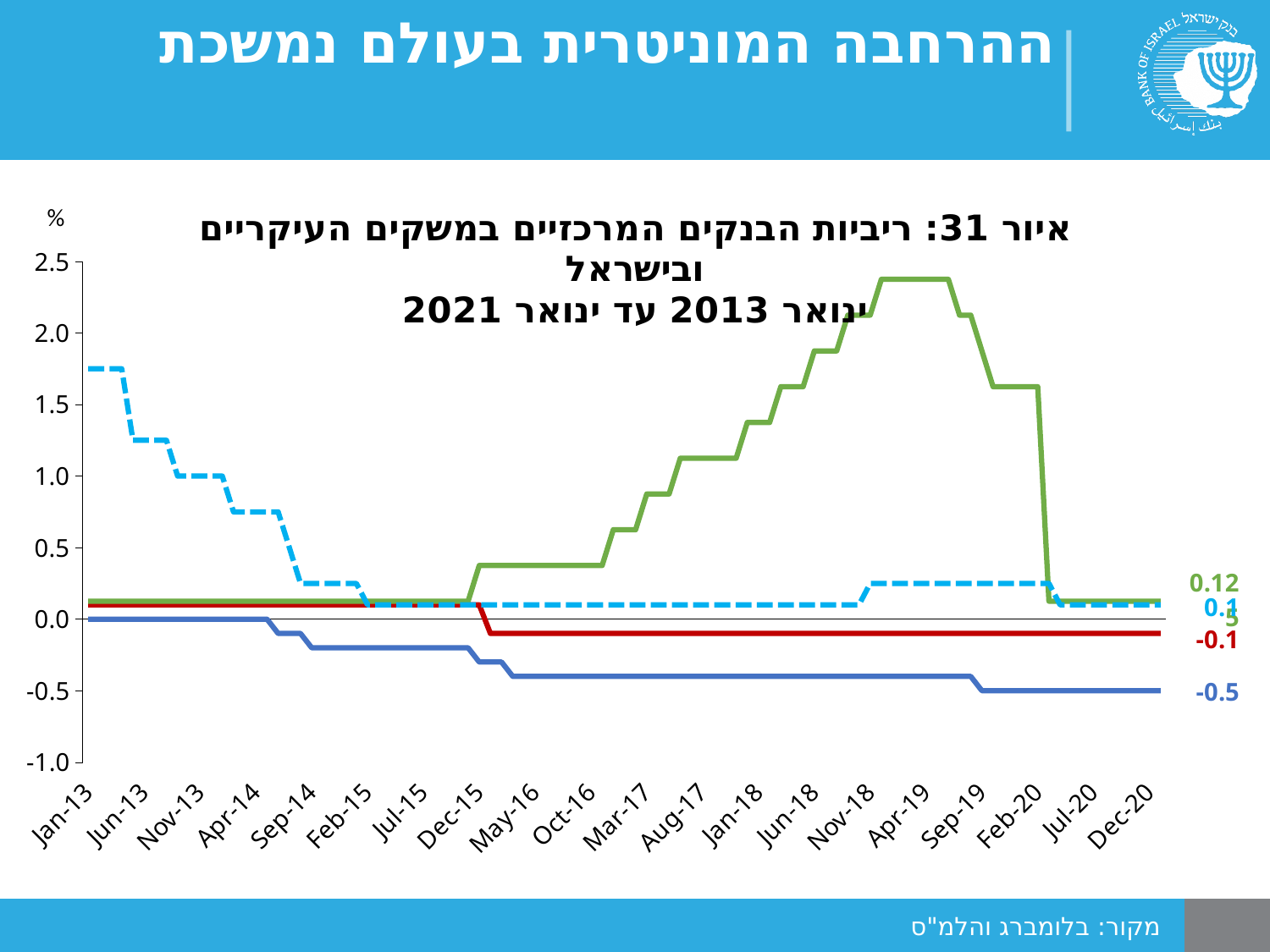
What is the final value labelled at the end of the solid blue line? -0.5 What unit is shown at the top of the vertical axis? % What kind of chart is shown on the slide? line chart Which line has the lowest value at the end of the period (Dec-20)? the solid blue line (-0.5) What is the final value labelled at the end of the red line? -0.1 Is the value of the dashed blue line at Jan-13 greater or less than 1.5? greater Is the peak of the green line (around Apr-19) greater or less than 2.0? greater How many lines are plotted on the chart? 4 What is the difference between the end values of the red line (-0.1) and the solid blue line (-0.5)? 0.4 Does the dashed blue line rise or fall between Jan-13 and Feb-15? fall Does the green line rise or fall between Dec-15 and Apr-19? rise At the end of the period, which is higher: the red line or the solid blue line? the red line